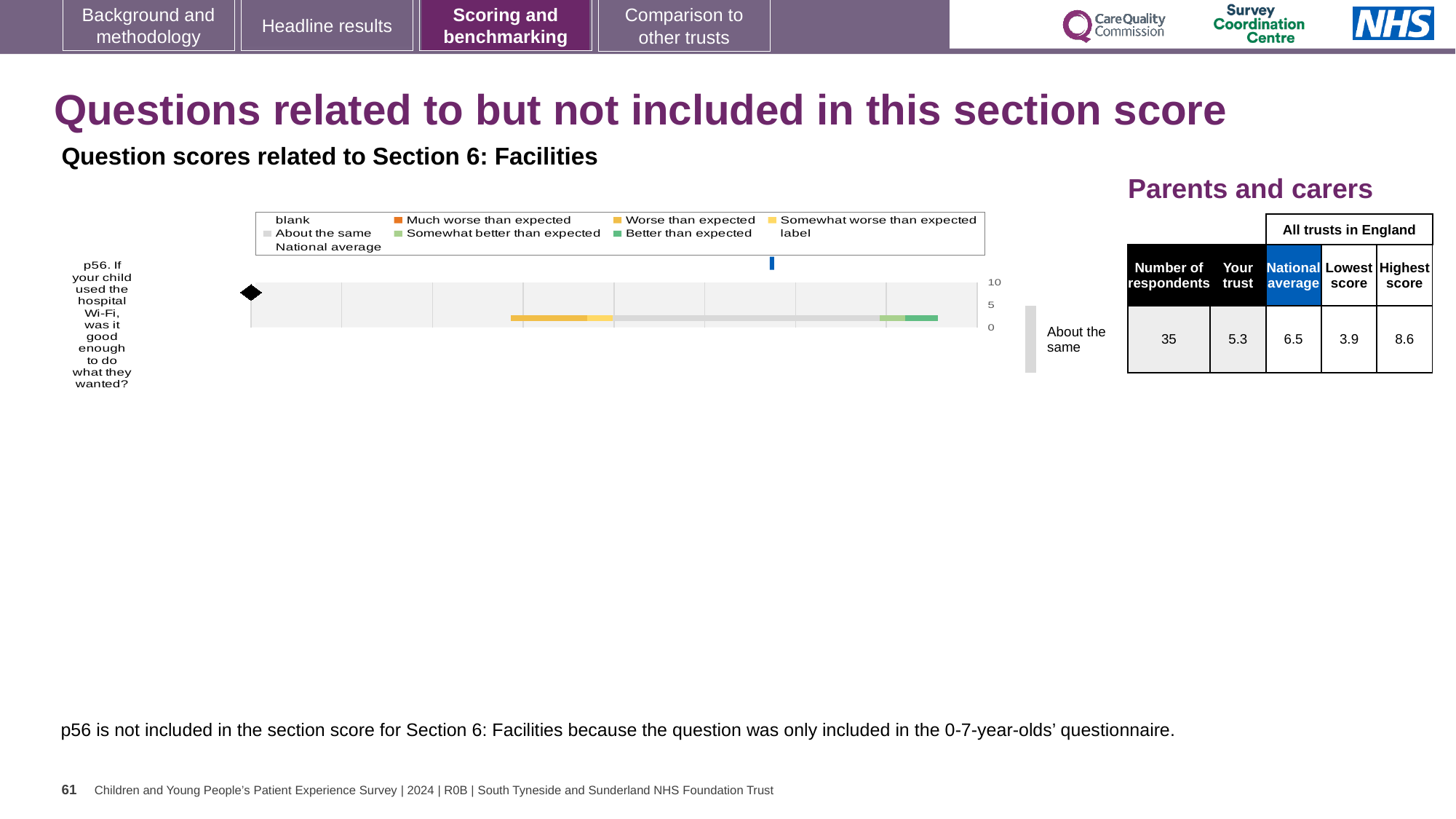
What kind of chart is shown for question p56? bar chart For p56, which is larger: the trust's score or the national average? National average In the table beside the chart, how many respondents answered p56? 35 In the table beside the chart, what is the highest score among all trusts in England for p56? 8.6 In the table beside the chart, what is the lowest score among all trusts in England for p56? 3.9 How many survey questions are plotted in the chart? 1 For p56, what is the difference between the national average and the trust's score? 1.2 What colour does the legend use for 'Better than expected'? green For p56, what is the difference between the highest and lowest scores across all trusts in England? 4.7 In the table beside the chart, what is the 'Your trust' score for p56? 5.3 What is the highest value shown on the chart's score axis? 10 In the table beside the chart, what is the national average score for p56? 6.5